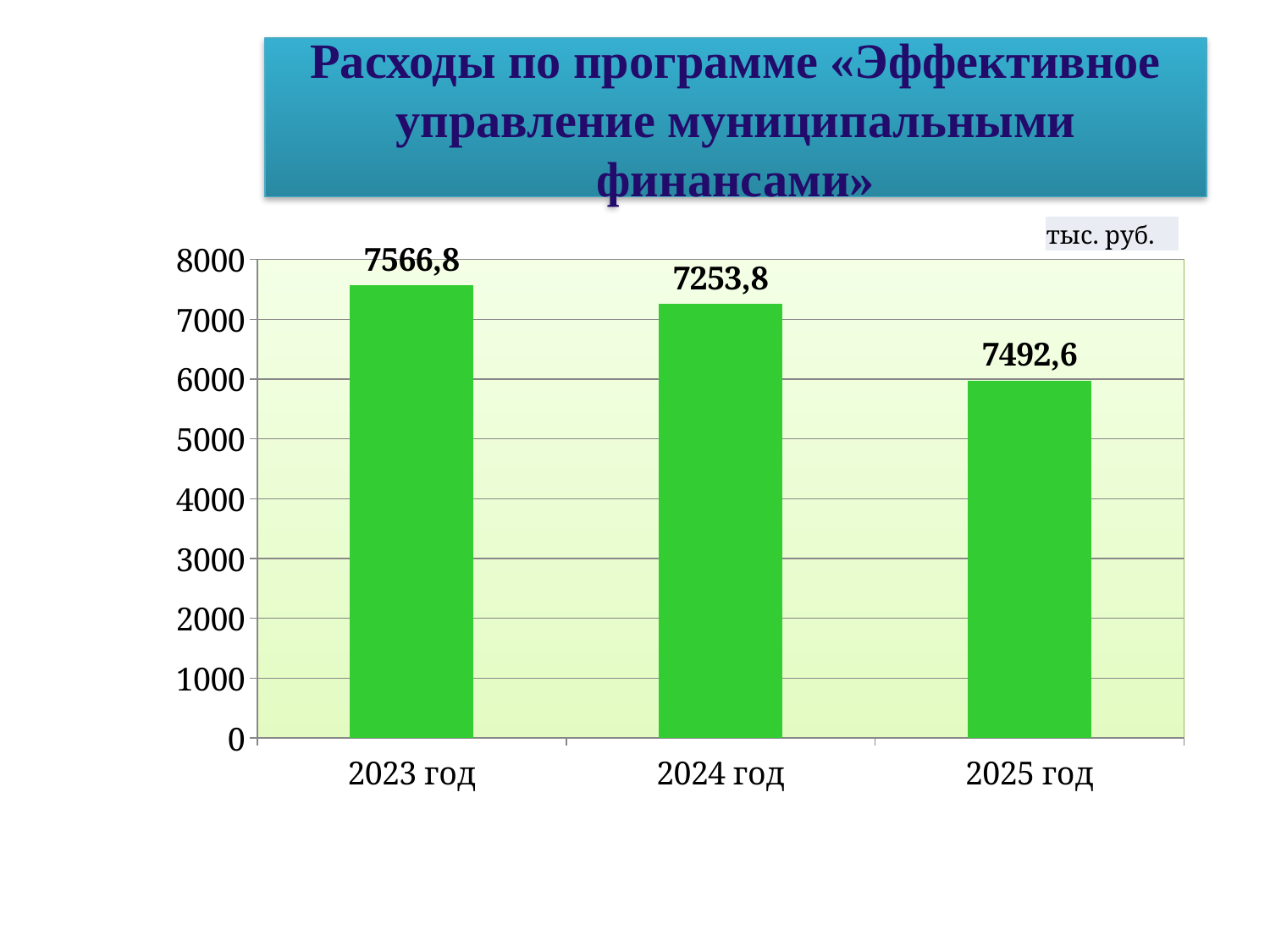
How many years are shown on the chart? 3 What is the difference between the values for 2023 год and 2024 год? 313 What is the value for 2025 год? 7492,6 Which is larger, the value for 2023 год or the value for 2024 год? 2023 год Which year has the highest value? 2023 год Is the value for 2023 год greater or less than 7000? greater What is the value for 2023 год? 7566,8 What is the value for 2024 год? 7253,8 What kind of chart is shown on the slide? bar chart What is the title of the chart? Расходы по программе «Эффективное управление муниципальными финансами» What unit is indicated for the values on the chart? тыс. руб. Is the value for 2024 год greater or less than 7000? greater